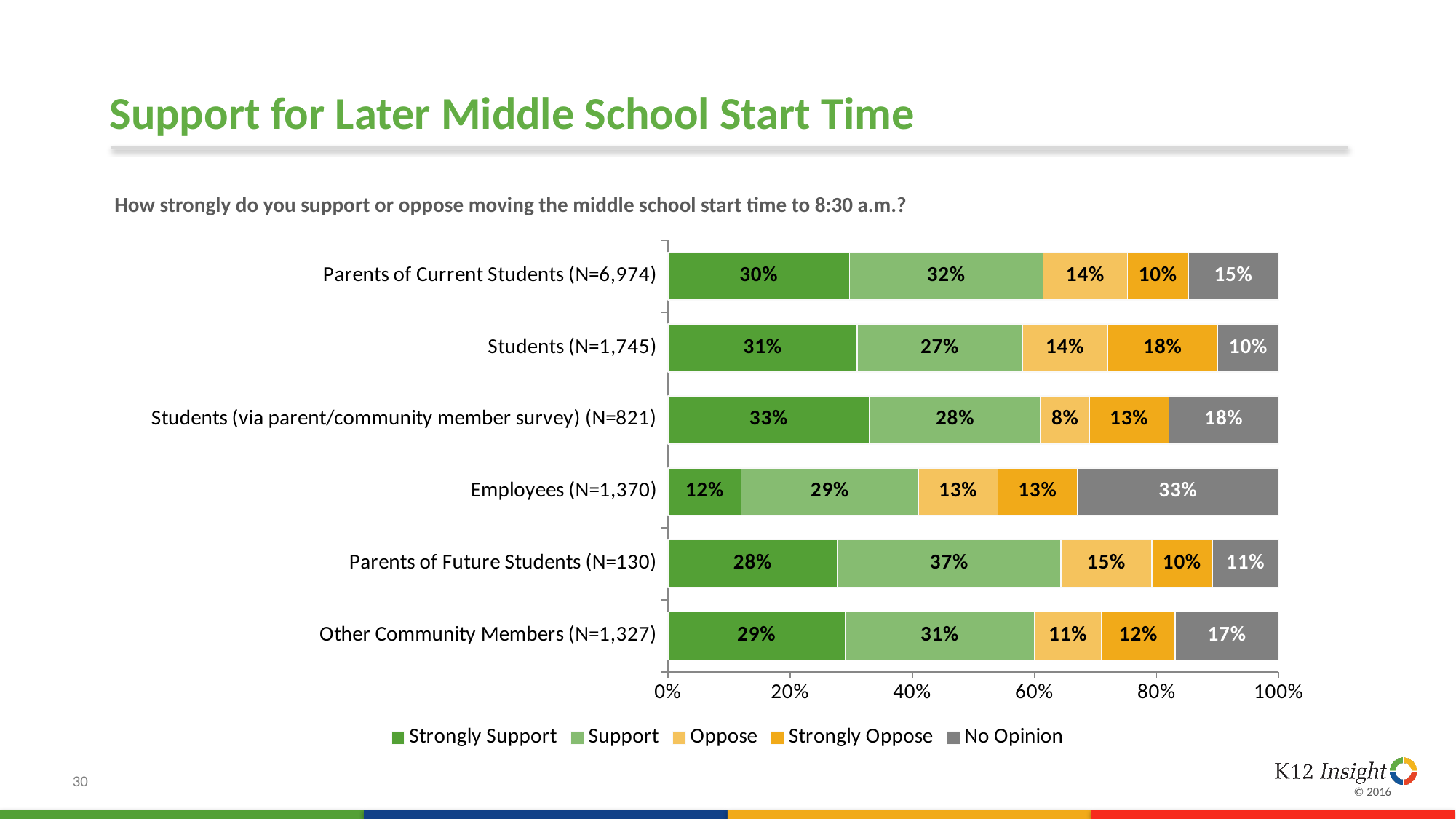
Which group has the lowest Strongly Support percentage? Employees (N=1,370) How many percentage points higher is the Strongly Oppose share for Students (N=1,745) than for Parents of Current Students (N=6,974)? 8 percentage points Which group has a larger No Opinion share: Employees (N=1,370) or Other Community Members (N=1,327)? Employees (N=1,370) What percentage of Employees (N=1,370) had No Opinion? 33% What type of chart is shown on the slide? Stacked bar chart Which group has the highest Strongly Support percentage? Students (via parent/community member survey) (N=821) What percentage of Students (N=1,745) said they Strongly Oppose the later start time? 18% How many response categories does the legend list? 5 What percentage of Students (via parent/community member survey) (N=821) said they Oppose the later start time? 8% Which group has the highest Support percentage? Parents of Future Students (N=130) What percentage of Employees (N=1,370) said they Strongly Support moving the middle school start time to 8:30 a.m.? 12% How many respondent groups are shown in the chart? 6